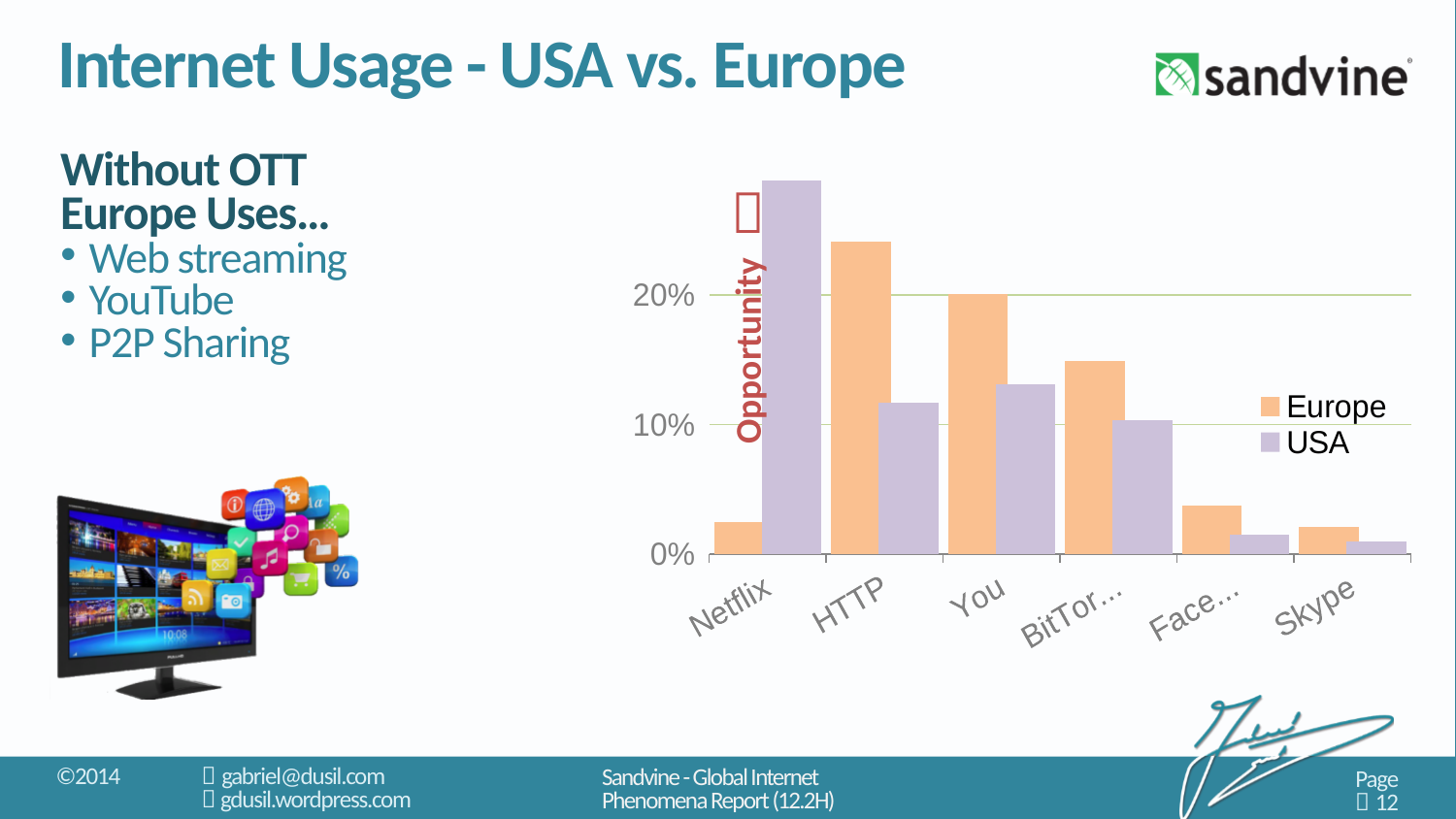
Which two series are listed in the chart's legend? Europe and USA What kind of chart is shown on the slide? bar chart Is the Europe value for Skype greater or less than 10%? less Which category has the highest USA value? Netflix Is the USA value for Netflix greater or less than 20%? greater For Netflix, which is larger, the Europe value or the USA value? USA How many series does the chart's legend list? 2 Is the Europe value for HTTP greater or less than 20%? greater How many categories are shown on the x axis of the chart? 6 Which category has the highest Europe value? HTTP For HTTP, which is larger, the Europe value or the USA value? Europe